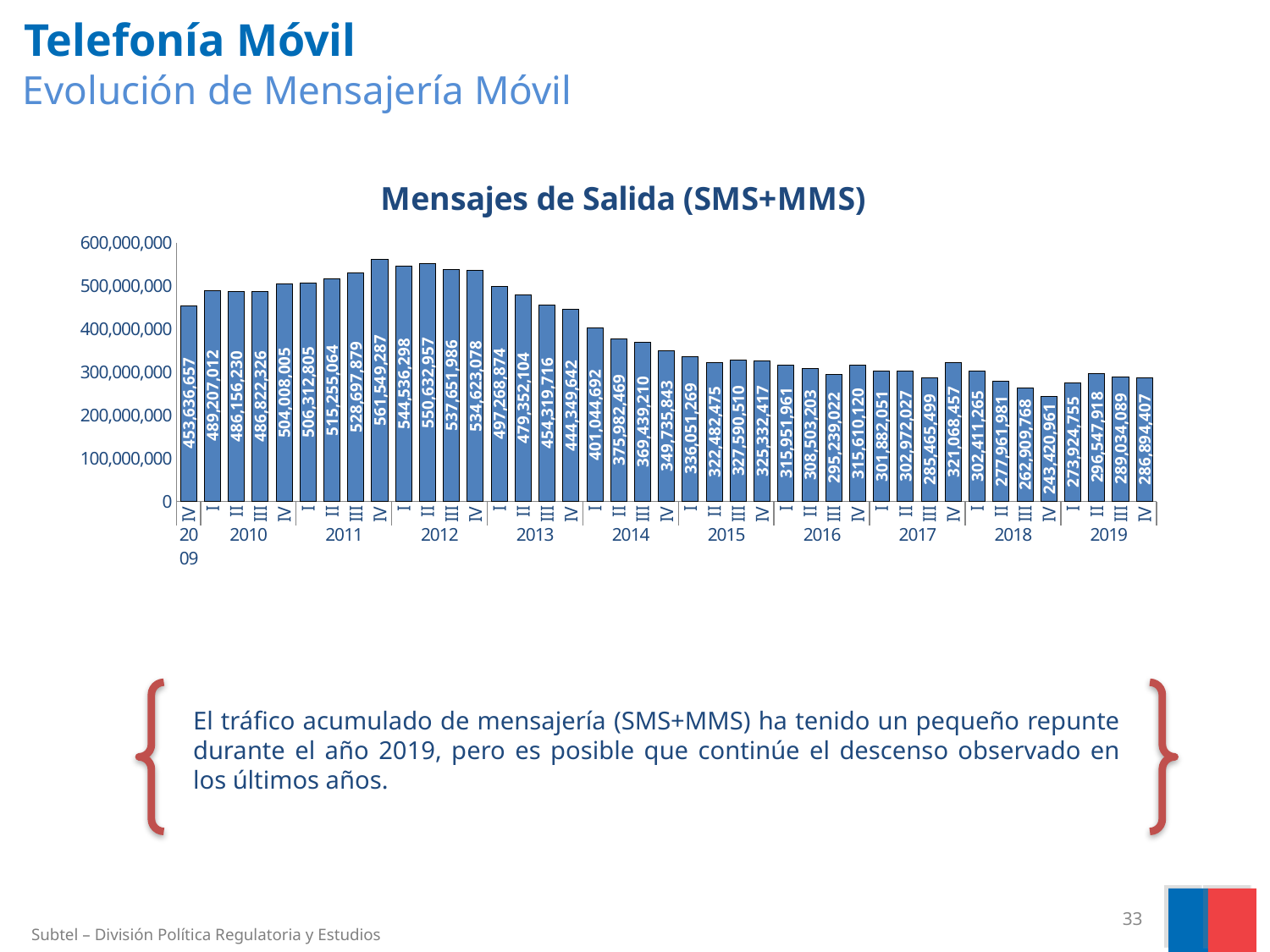
What is the title of the chart? Mensajes de Salida (SMS+MMS) What is the value for quarter IV of 2019? 286,894,407 What is the value for quarter IV of 2011? 561,549,287 Do the values generally rise or fall from 2012 to 2018? Fall What is the value for quarter I of 2014? 401,044,692 What is the value for quarter IV of 2018? 243,420,961 Which quarter has the lowest value? IV 2018 Which is larger, the value for quarter I of 2019 or quarter II of 2019? II 2019 Is the value for quarter II of 2014 greater or less than 400,000,000? less What type of chart is shown on the slide? Bar chart Which quarter has the highest value? IV 2011 What is the difference between the values for quarter IV of 2019 and quarter IV of 2018? 43,473,446